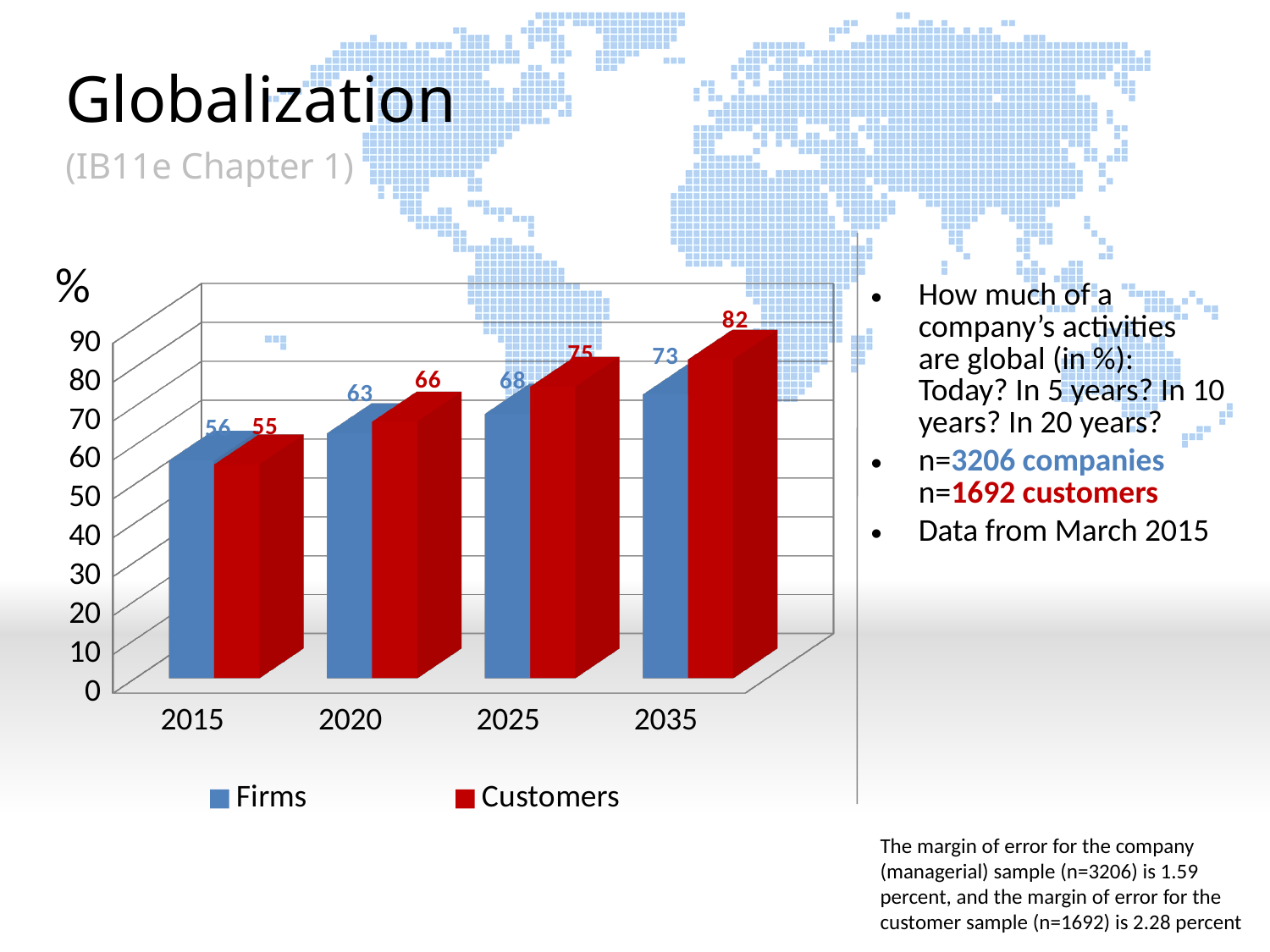
How many series does the legend list? 2 In which year is the Firms value highest? 2035 What kind of chart is shown on the slide? bar chart Which is larger in 2035, the Firms value or the Customers value? Customers Do the Customers values rise or fall from 2015 to 2035? rise What is the difference between the Customers and Firms values in 2025? 7 How many years are shown on the x axis? 4 What is the value for Firms in 2020? 63 In which year is the Customers value lowest? 2015 Is the value for Firms in 2015 greater or less than 50? greater What is the value for Customers in 2015? 55 What is the value for Customers in 2035? 82